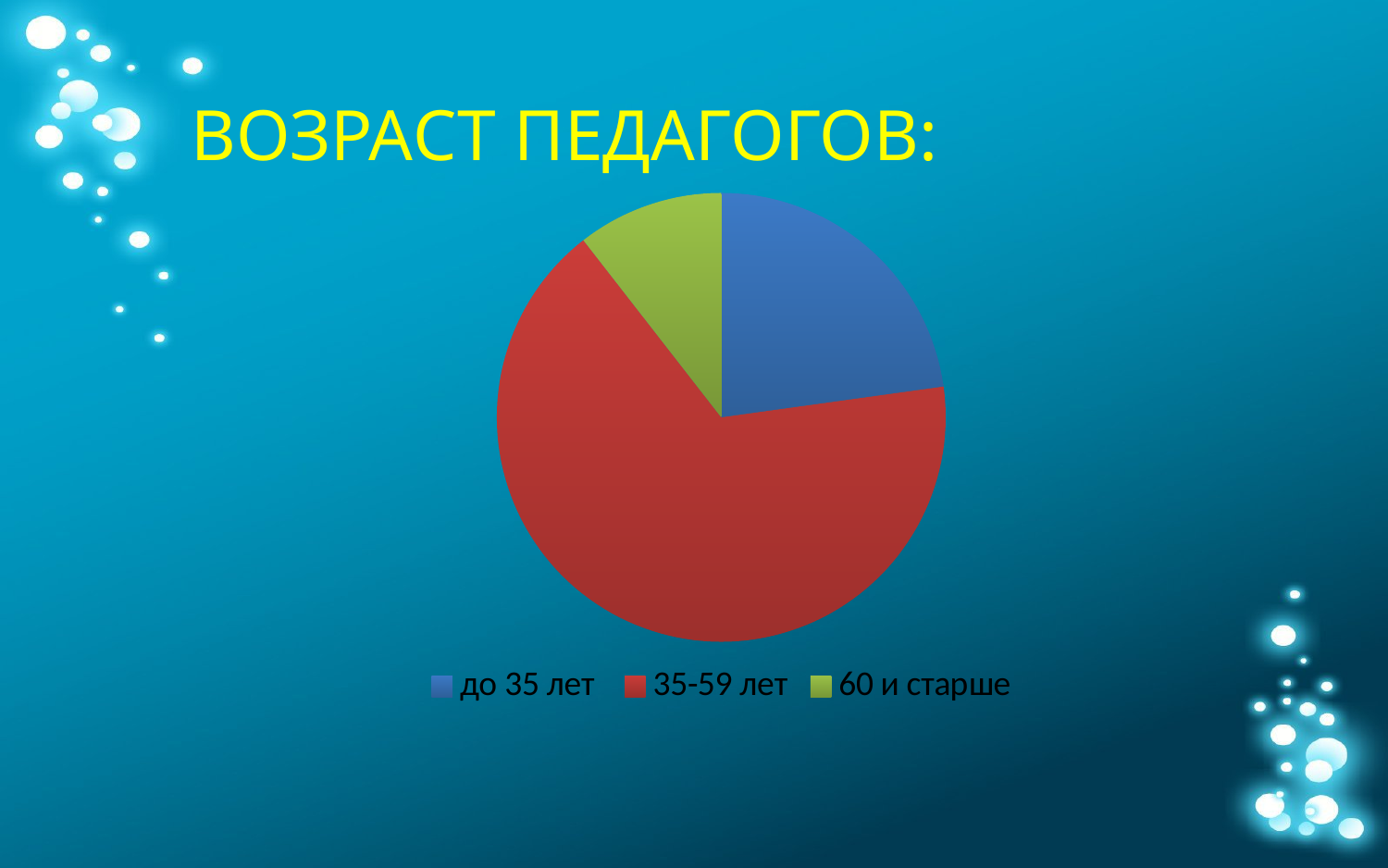
What kind of chart is shown on the slide? pie chart How many slices does the pie chart have? 3 Which age group has the largest slice of the pie? 35-59 лет Which slice is larger: "35-59 лет" or "до 35 лет"? 35-59 лет How many entries does the legend list? 3 What colour represents the "35-59 лет" group in the pie chart? red Does the "35-59 лет" slice take up more or less than half of the pie? more Which slice is larger: "до 35 лет" or "60 и старше"? до 35 лет What is the title of the chart on the slide? ВОЗРАСТ ПЕДАГОГОВ: Which age group has the smallest slice of the pie? 60 и старше